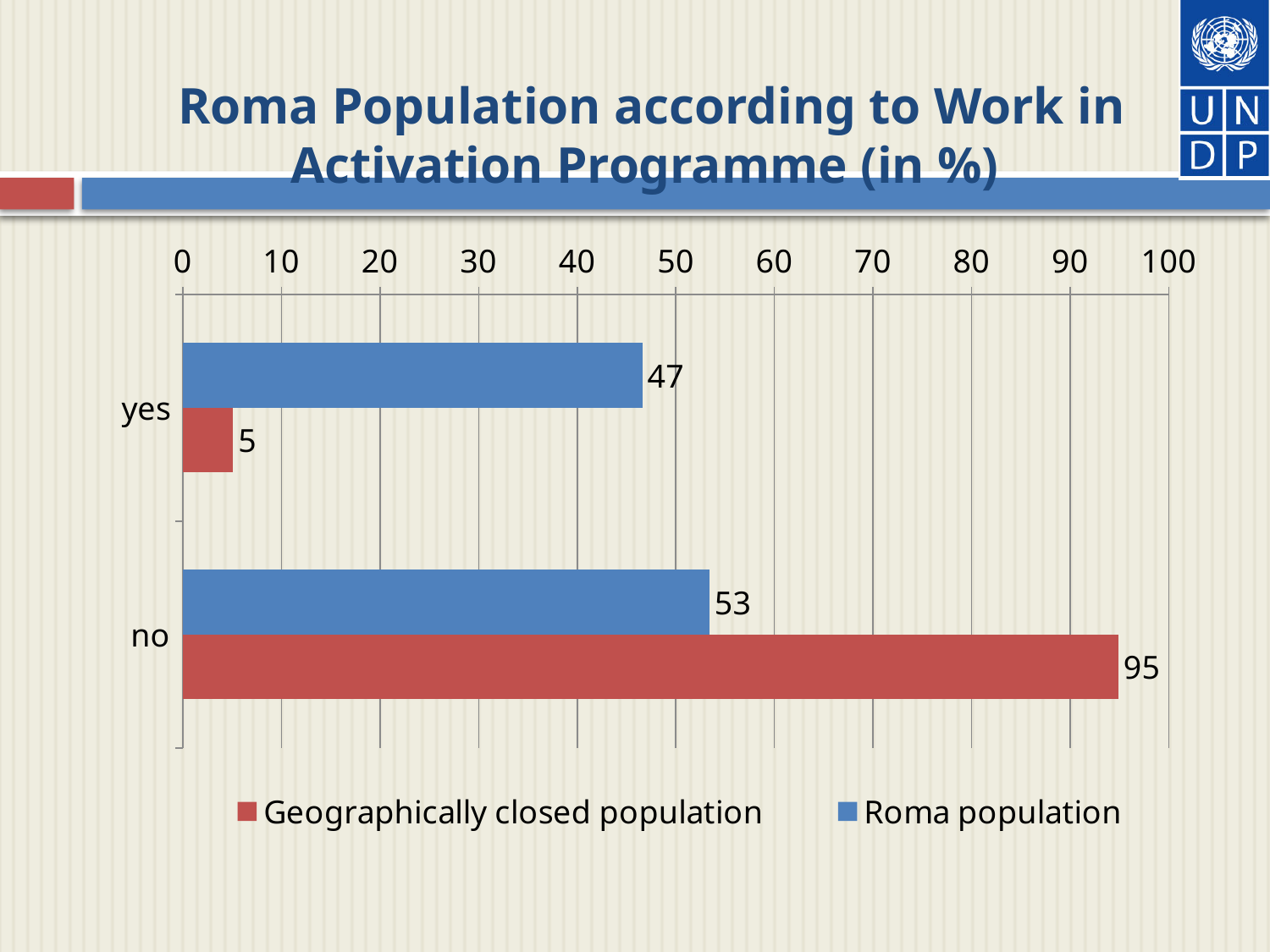
How many categories are shown on the chart? 2 What is the difference between the Geographically closed population and the Roma population in the "no" category? 42 What kind of chart is shown on the slide? Bar chart What is the value for the Roma population in the "no" category? 53 What is the difference between the Roma population values for "no" and "yes"? 6 In the "yes" category, which series has the larger value: Roma population or Geographically closed population? Roma population What is the value for the Roma population in the "yes" category? 47 Which bar has the highest value on the chart? Geographically closed population, no Which bar has the lowest value on the chart? Geographically closed population, yes What is the value for the Geographically closed population in the "no" category? 95 What is the value for the Geographically closed population in the "yes" category? 5 How many series does the legend list? 2